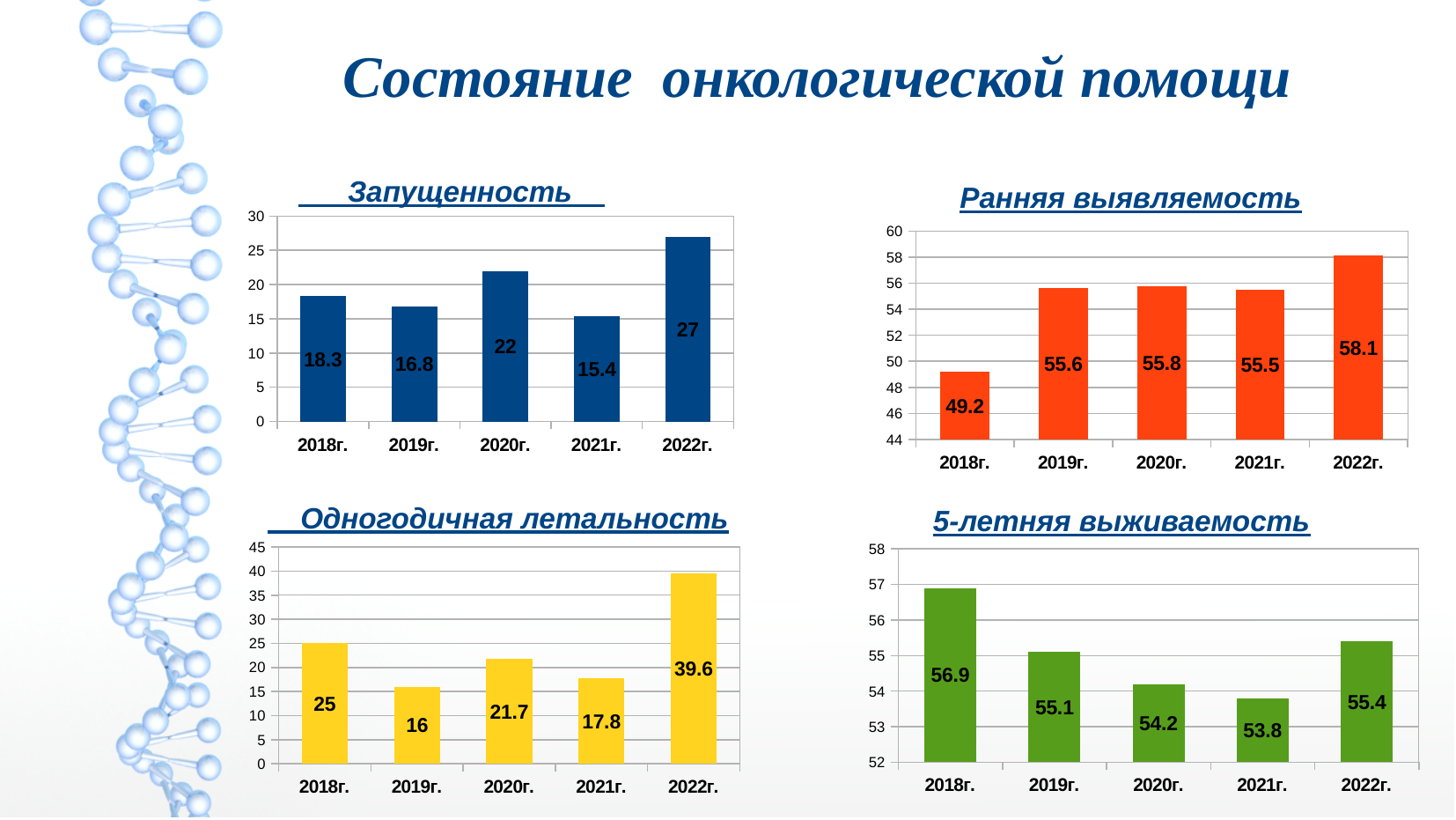
In the 'Запущенность' chart, which year has the lowest value? 2021г. In the 'Одногодичная летальность' chart, what is the difference between the values for 2022г. and 2019г.? 23.6 In the 'Запущенность' chart, what is the value for 2022г.? 27 In the 'Одногодичная летальность' chart, what is the value for 2020г.? 21.7 In the '5-летняя выживаемость' chart, what is the value for 2021г.? 53.8 What type of chart is the 'Запущенность' chart? Bar chart In the 'Ранняя выявляемость' chart, what is the difference between the values for 2022г. and 2018г.? 8.9 How many years are shown in the '5-летняя выживаемость' chart? 5 In the 'Одногодичная летальность' chart, which is larger, the value for 2018г. or the value for 2021г.? 2018г. In the 'Ранняя выявляемость' chart, what is the value for 2018г.? 49.2 In the 'Ранняя выявляемость' chart, which year has the highest value? 2022г. In the '5-летняя выживаемость' chart, which year has the highest value? 2018г.